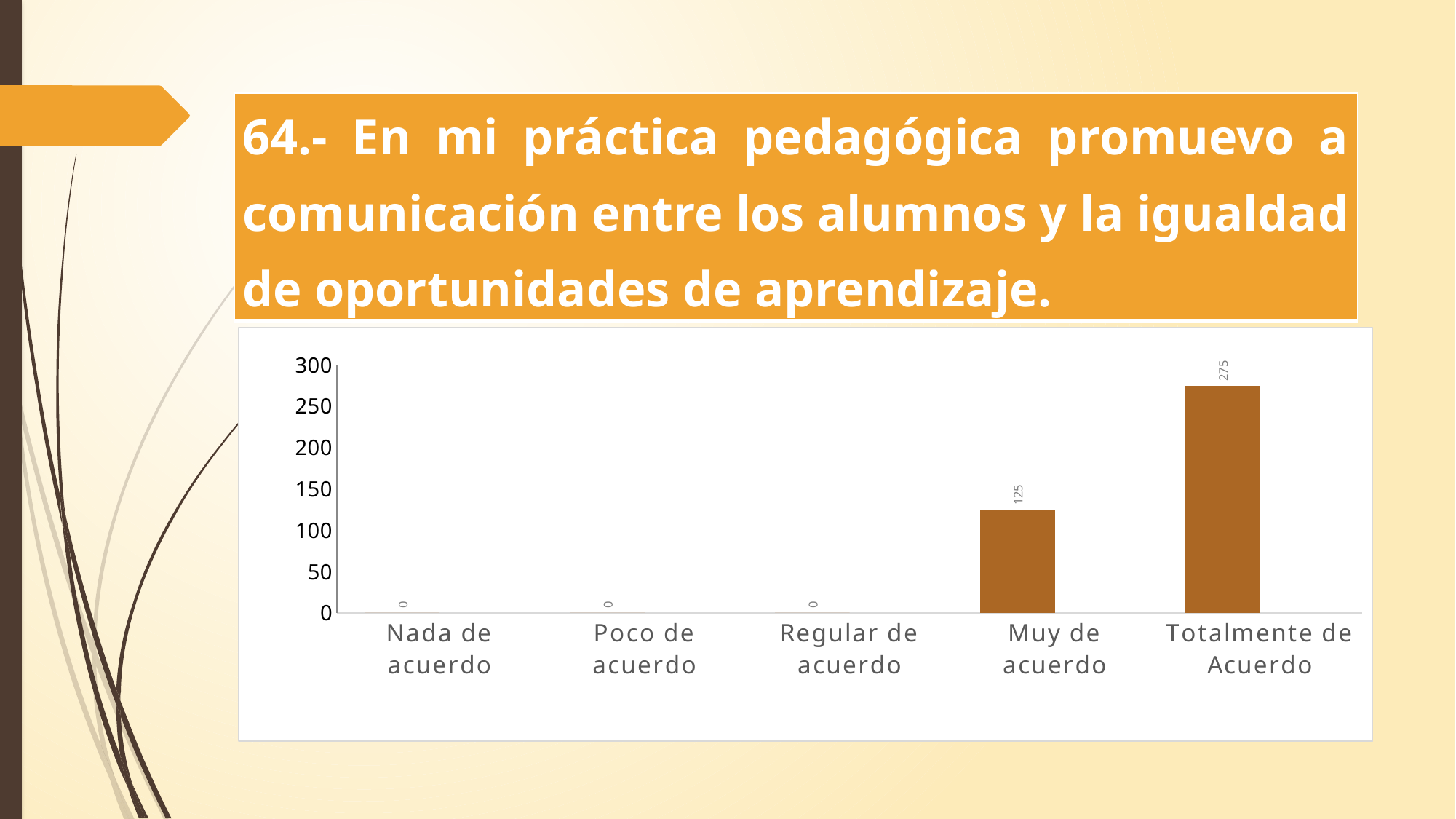
Which category has the highest value? Totalmente de Acuerdo Is the value for "Muy de acuerdo" greater or less than 100? greater Which is larger, the value for "Muy de acuerdo" or the value for "Totalmente de Acuerdo"? Totalmente de Acuerdo Do the values rise or fall from left to right along the x axis? Rise What is the value for "Muy de acuerdo"? 125 What is the value for "Regular de acuerdo"? 0 What is the value for "Totalmente de Acuerdo"? 275 Is the value for "Totalmente de Acuerdo" greater or less than 250? greater What is the difference between the values for "Totalmente de Acuerdo" and "Muy de acuerdo"? 150 How many categories are shown on the x axis? 5 What is the value for "Nada de acuerdo"? 0 What kind of chart is shown on the slide? Bar chart